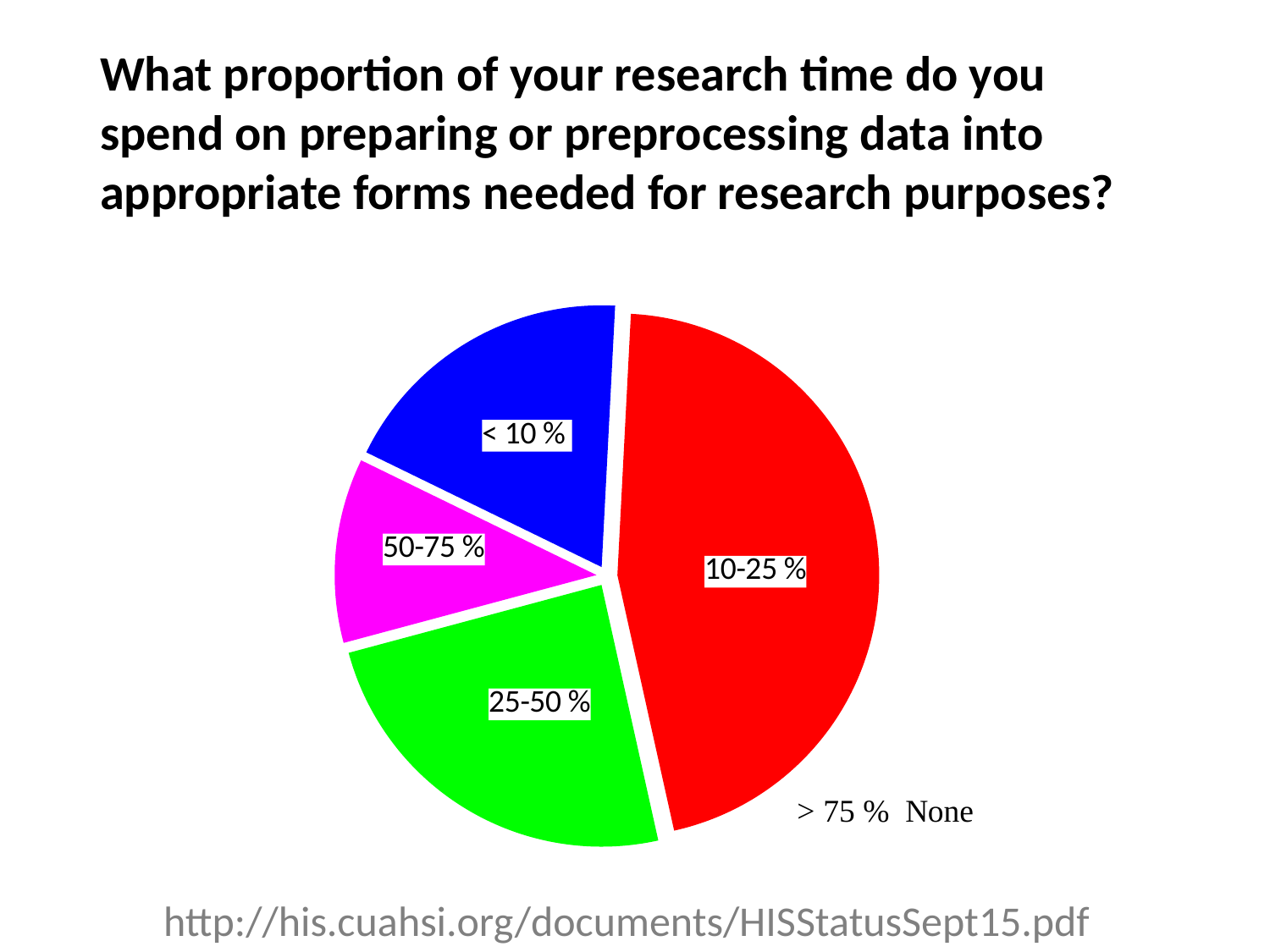
Which slice is larger, < 10 % or 50-75 %? < 10 % How many coloured slices are visible in the pie chart? 4 Which slice is larger, 10-25 % or 25-50 %? 10-25 % Which of the coloured slices is the smallest? 50-75 % Which slice is larger, 25-50 % or 50-75 %? 25-50 % What colour is the < 10 % slice? blue What colour is the 10-25 % slice? red Does the 10-25 % slice make up more or less than half of the pie? less What kind of chart is shown on the slide? pie chart Which category has the largest slice of the pie? 10-25 %